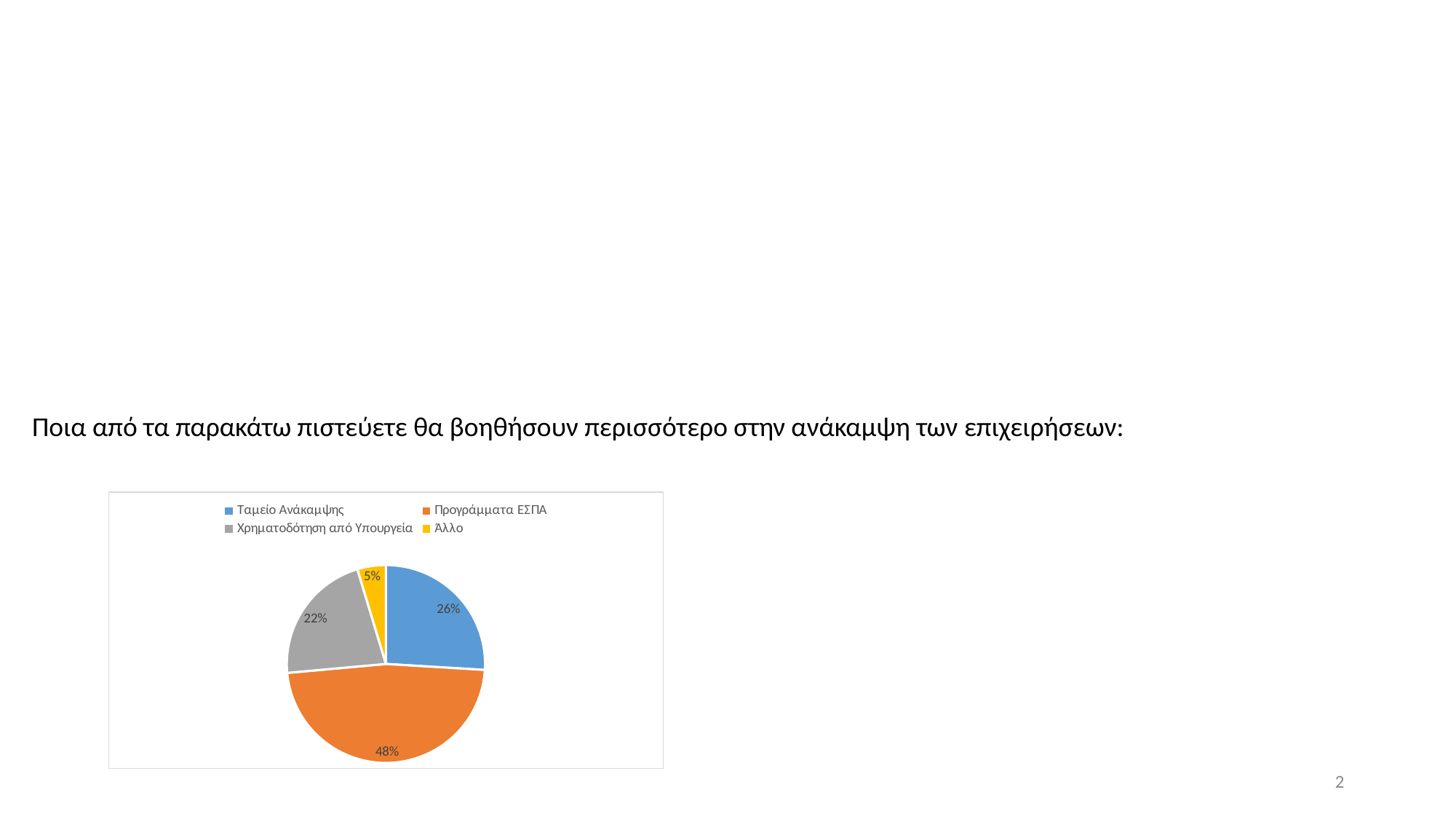
What share of the pie does Ταμείο Ανάκαμψης represent? 26% What share of the pie does Χρηματοδότηση από Υπουργεία represent? 22% What type of chart is shown on the slide? Pie chart Which legend entry is shown in yellow? Άλλο Which category has the smallest slice of the pie? Άλλο Which is larger: the slice for Ταμείο Ανάκαμψης or the slice for Χρηματοδότηση από Υπουργεία? Ταμείο Ανάκαμψης What colour is the slice for Προγράμματα ΕΣΠΑ? Orange Which category has the largest slice of the pie? Προγράμματα ΕΣΠΑ What is the difference in percentage points between Προγράμματα ΕΣΠΑ and Ταμείο Ανάκαμψης? 22 percentage points What share of the pie does Άλλο represent? 5% How many categories does the pie chart show? 4